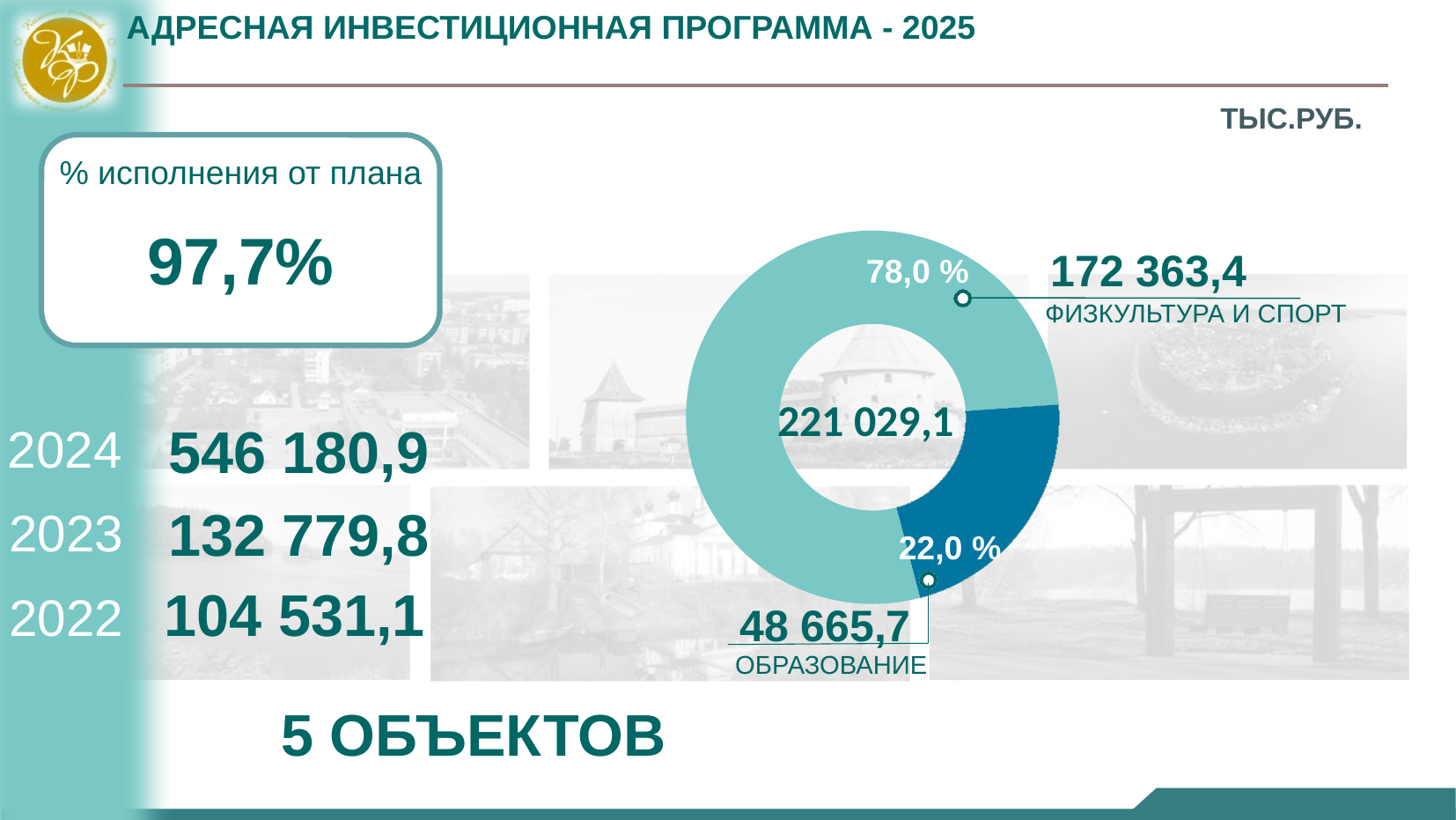
In what units are the values on the slide expressed? ТЫС.РУБ. What total value is shown in the centre of the donut chart? 221 029,1 What is the difference between the values for ФИЗКУЛЬТУРА И СПОРТ and ОБРАЗОВАНИЕ in the donut chart? 123 697,7 What percentage share does ФИЗКУЛЬТУРА И СПОРТ have in the donut chart? 78,0 % Which category has the largest slice in the donut chart? ФИЗКУЛЬТУРА И СПОРТ How many categories are shown in the donut chart? 2 What type of chart is shown on the slide? Donut (pie) chart What value is shown for ОБРАЗОВАНИЕ in the donut chart? 48 665,7 What percentage share does ОБРАЗОВАНИЕ have in the donut chart? 22,0 % Which category has the smallest slice in the donut chart? ОБРАЗОВАНИЕ What value is shown for ФИЗКУЛЬТУРА И СПОРТ in the donut chart? 172 363,4 Which is larger in the donut chart: ФИЗКУЛЬТУРА И СПОРТ or ОБРАЗОВАНИЕ? ФИЗКУЛЬТУРА И СПОРТ